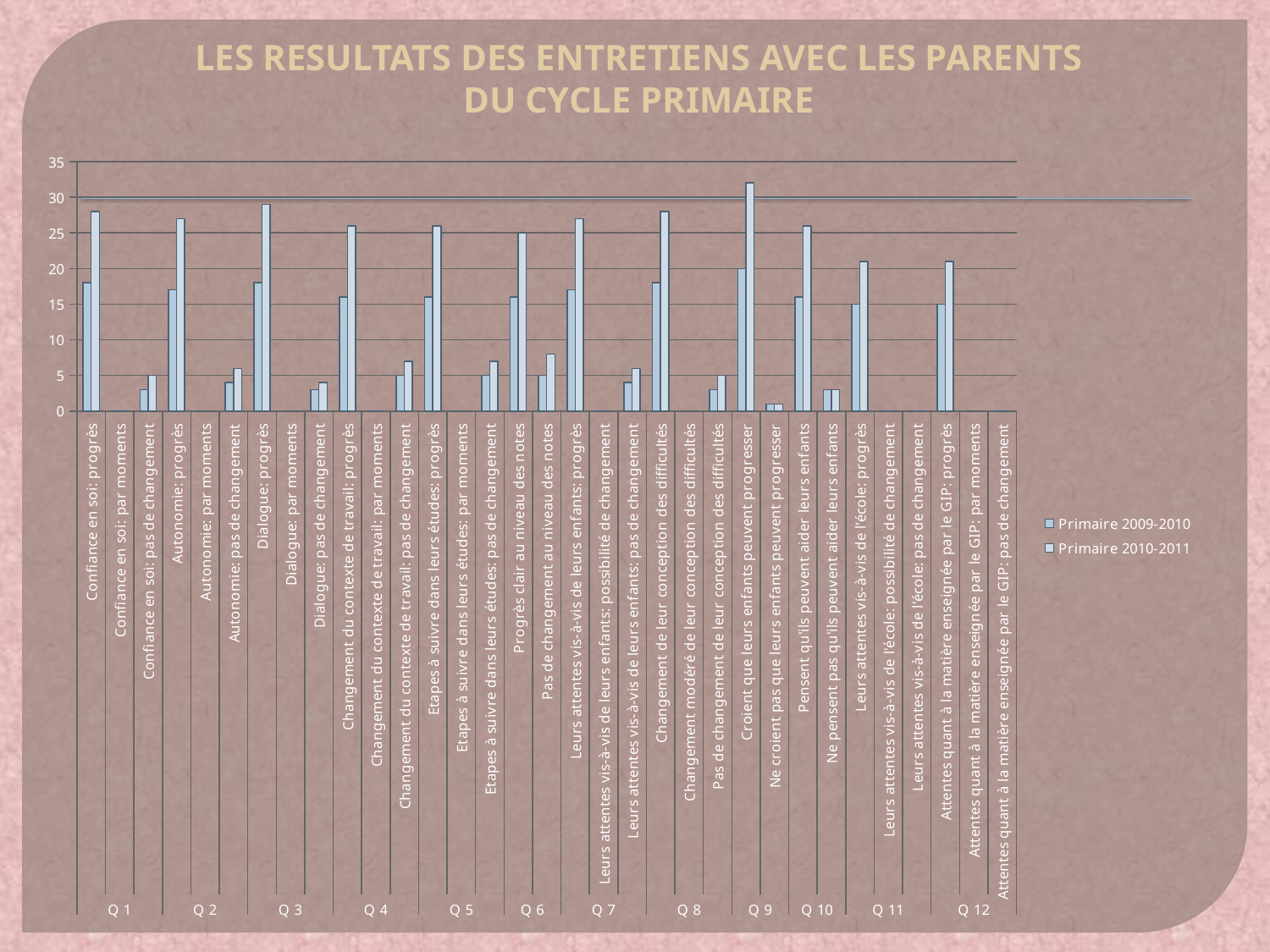
Which is larger: the Primaire 2010-2011 value for 'Confiance en soi: progrès' or the Primaire 2010-2011 value for 'Confiance en soi: pas de changement'? Confiance en soi: progrès How many question groups (Q 1 to Q 12) are shown along the x axis? 12 Is the Primaire 2010-2011 value for 'Dialogue: progrès' greater or less than 25? greater What are the two series named in the legend? Primaire 2009-2010 and Primaire 2010-2011 Is the Primaire 2009-2010 value for 'Confiance en soi: progrès' greater or less than 15? greater Is the Primaire 2009-2010 value for 'Dialogue: pas de changement' greater or less than 5? less Which category has the highest bar for Primaire 2010-2011? Croient que leurs enfants peuvent progresser For 'Autonomie: progrès', which series has the larger value, Primaire 2009-2010 or Primaire 2010-2011? Primaire 2010-2011 What kind of chart is shown on the slide? bar chart How many series does the legend list? 2